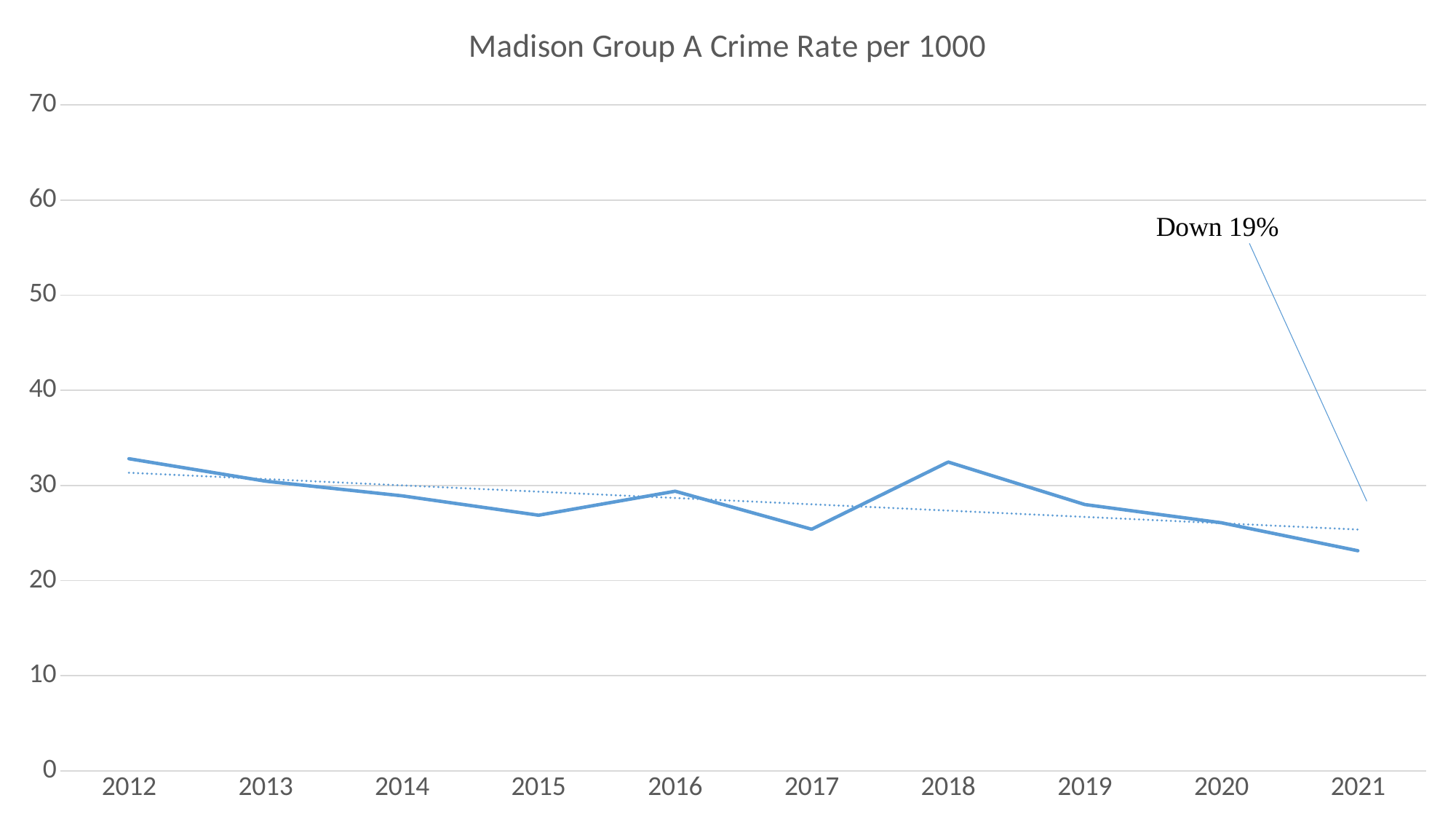
What does the annotation pointing to the 2021 end of the line say? Down 19% Is the value for 2012 greater or less than 30? greater How many years are plotted along the x axis? 10 Overall, does the crime rate rise or fall from 2012 to 2021? fall Is the value for 2018 greater or less than 30? greater Is the value for 2017 greater or less than 30? less What is the title of the chart? Madison Group A Crime Rate per 1000 Which year has the higher value, 2016 or 2015? 2016 Which year has the lowest crime rate? 2021 Which year has the higher value, 2018 or 2017? 2018 What kind of chart is shown on the slide? line chart